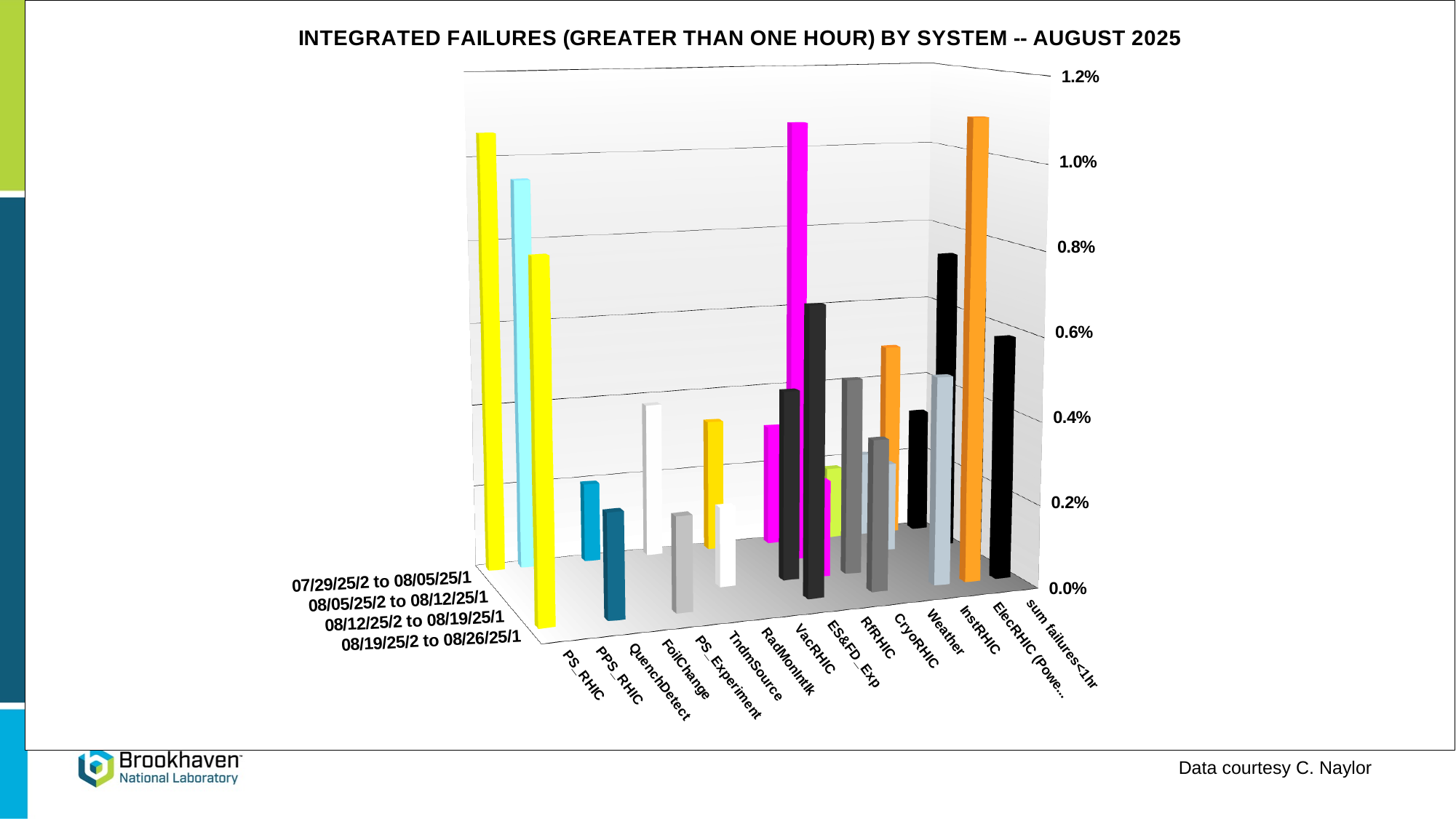
Is the value for VacRHIC in the 07/29/25/2 to 08/05/25/1 period greater or less than 0.6%? less Is the value for PS_RHIC in the 07/29/25/2 to 08/05/25/1 period greater or less than 0.6%? greater How many system categories are shown along the horizontal axis of the chart? 15 What is the highest value shown on the vertical axis of the chart? 1.2% How many weekly time periods are shown on the depth axis of the chart? 4 What kind of chart is shown on the slide? bar chart Is the value for InstRHIC in the 07/29/25/2 to 08/05/25/1 period greater or less than 0.6%? less What is the title of the chart? INTEGRATED FAILURES (GREATER THAN ONE HOUR) BY SYSTEM -- AUGUST 2025 Which is larger in the 07/29/25/2 to 08/05/25/1 period, the value for PS_RHIC or the value for PPS_RHIC? PS_RHIC